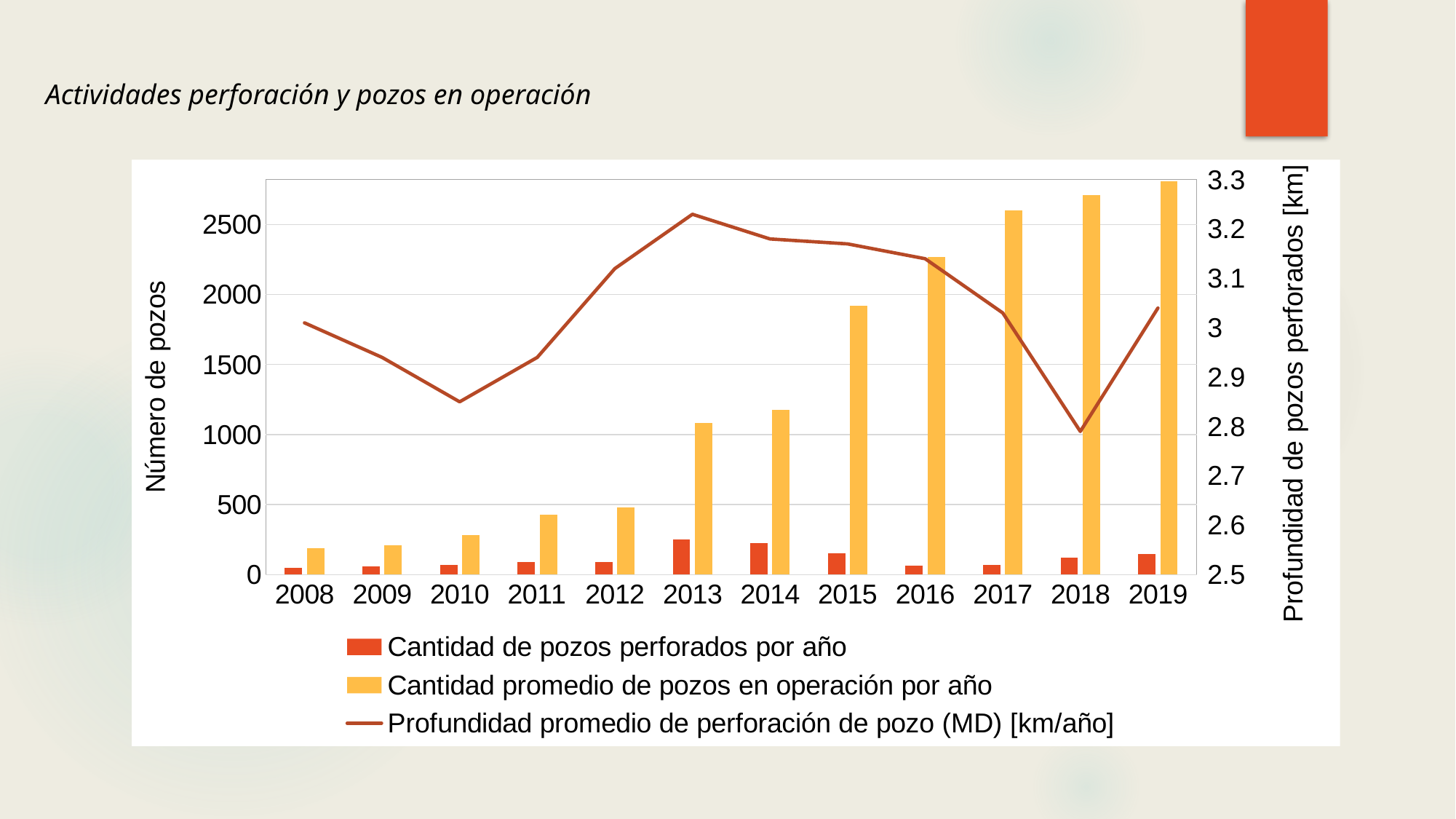
In which year does the 'Profundidad promedio de perforación de pozo (MD)' line reach its highest point? 2013 What kind of chart is shown on the slide? A combined bar and line chart How many series does the legend list? 3 Does the 'Cantidad promedio de pozos en operación por año' series rise or fall from 2008 to 2019? Rise How many years are shown on the x axis? 12 Is the 'Cantidad promedio de pozos en operación por año' value for 2016 greater or less than 2000? greater Is the 'Profundidad promedio de perforación de pozo (MD)' value for 2018 greater or less than 2.9? less What is the title of the right-hand vertical axis? Profundidad de pozos perforados [km] In which year does the 'Profundidad promedio de perforación de pozo (MD)' line reach its lowest point? 2018 Is the 'Cantidad promedio de pozos en operación por año' value for 2015 greater or less than 1500? greater In which year is the 'Cantidad promedio de pozos en operación por año' bar the highest? 2019 Which year has the larger 'Cantidad de pozos perforados por año' bar, 2013 or 2016? 2013